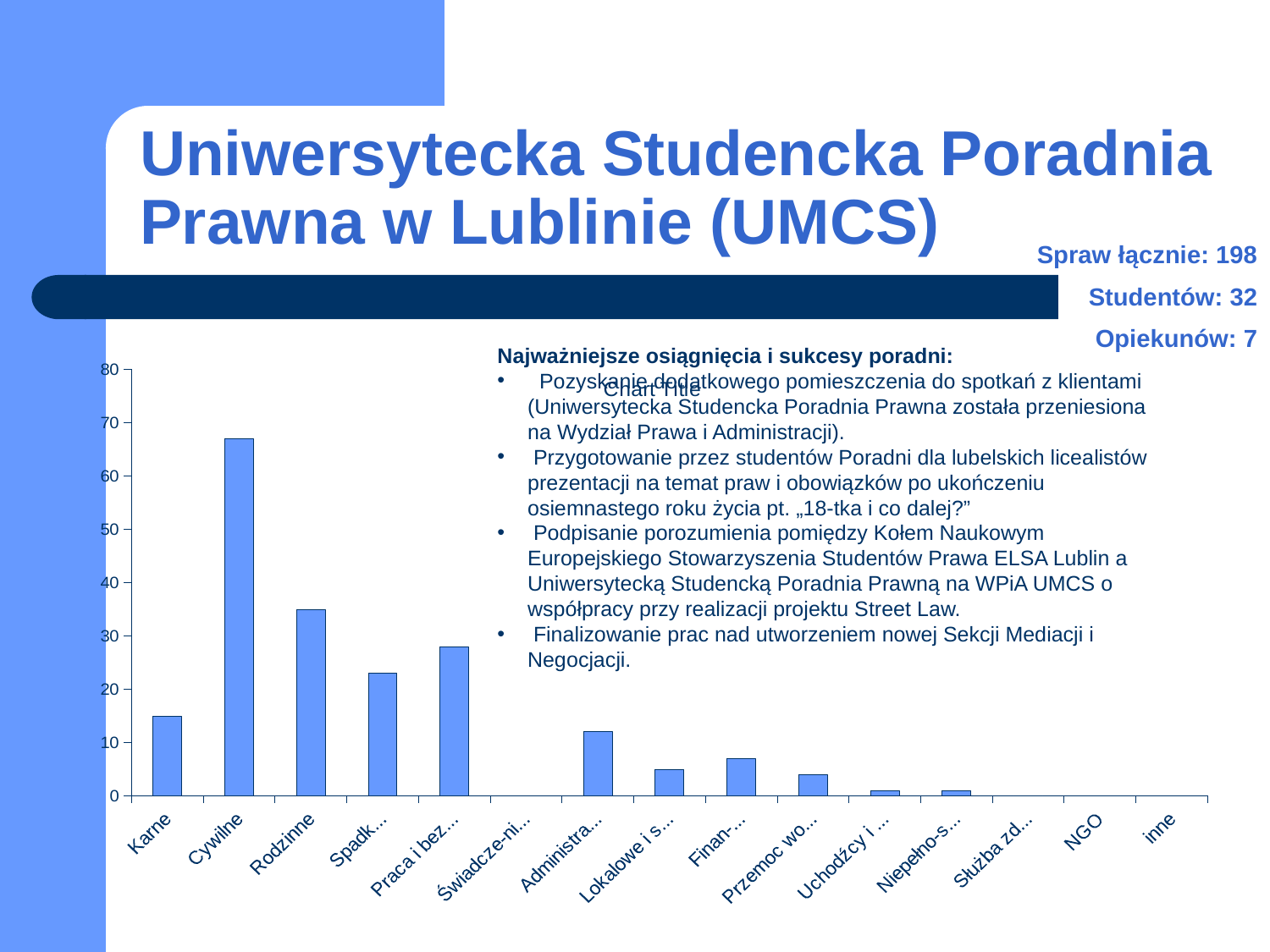
How many categories are shown on the x axis of the chart? 15 Which is larger, the value for Cywilne or the value for Rodzinne? Cywilne What colour are the bars in the chart? blue Is the value for Rodzinne greater or less than 30? greater Is the value for Spadk... greater or less than 20? greater Is the value for Karne greater or less than 10? greater What kind of chart is shown on the slide? bar chart Which is larger, the value for Rodzinne or the value for Karne? Rodzinne Which category has the highest bar in the chart? Cywilne